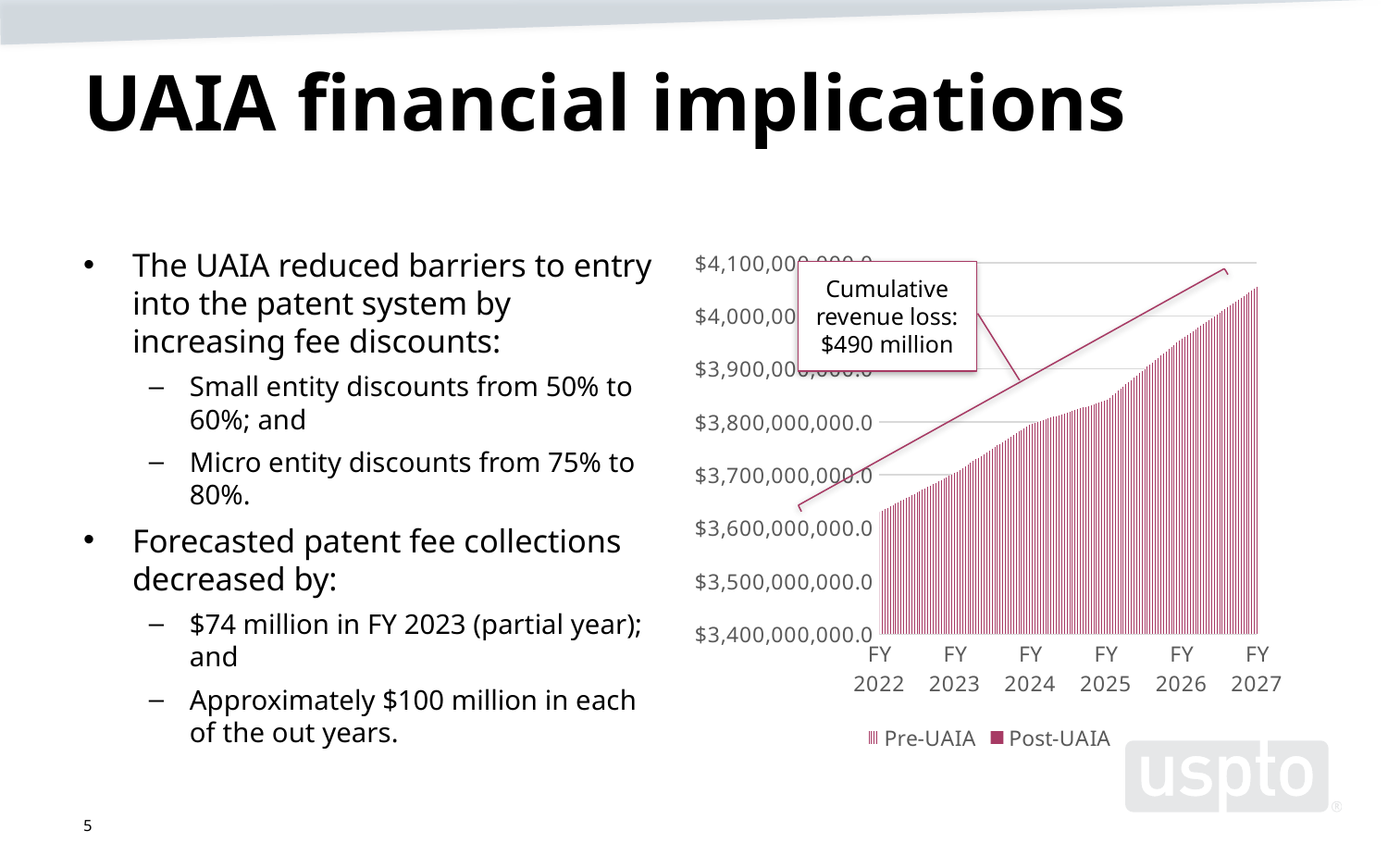
Which fiscal year is the first category on the chart's x axis? FY 2022 Do the plotted values rise or fall from FY 2022 to FY 2027? rise Is the value of the shaded series at FY 2027 greater or less than $4,000,000,000.0? less How many fiscal years are shown on the x axis of the chart? 6 Is the value of the shaded series at FY 2025 greater or less than $3,800,000,000.0? less What is the highest tick label on the chart's y axis? $4,100,000,000.0 How many series does the chart legend list? 2 What are the two series named in the chart legend? Pre-UAIA and Post-UAIA What cumulative revenue loss does the annotation on the chart state? $490 million Is the value of the shaded series at FY 2022 greater or less than $3,600,000,000.0? greater Which fiscal year has the higher value for the shaded series, FY 2022 or FY 2027? FY 2027 What is the lowest tick label on the chart's y axis? $3,400,000,000.0